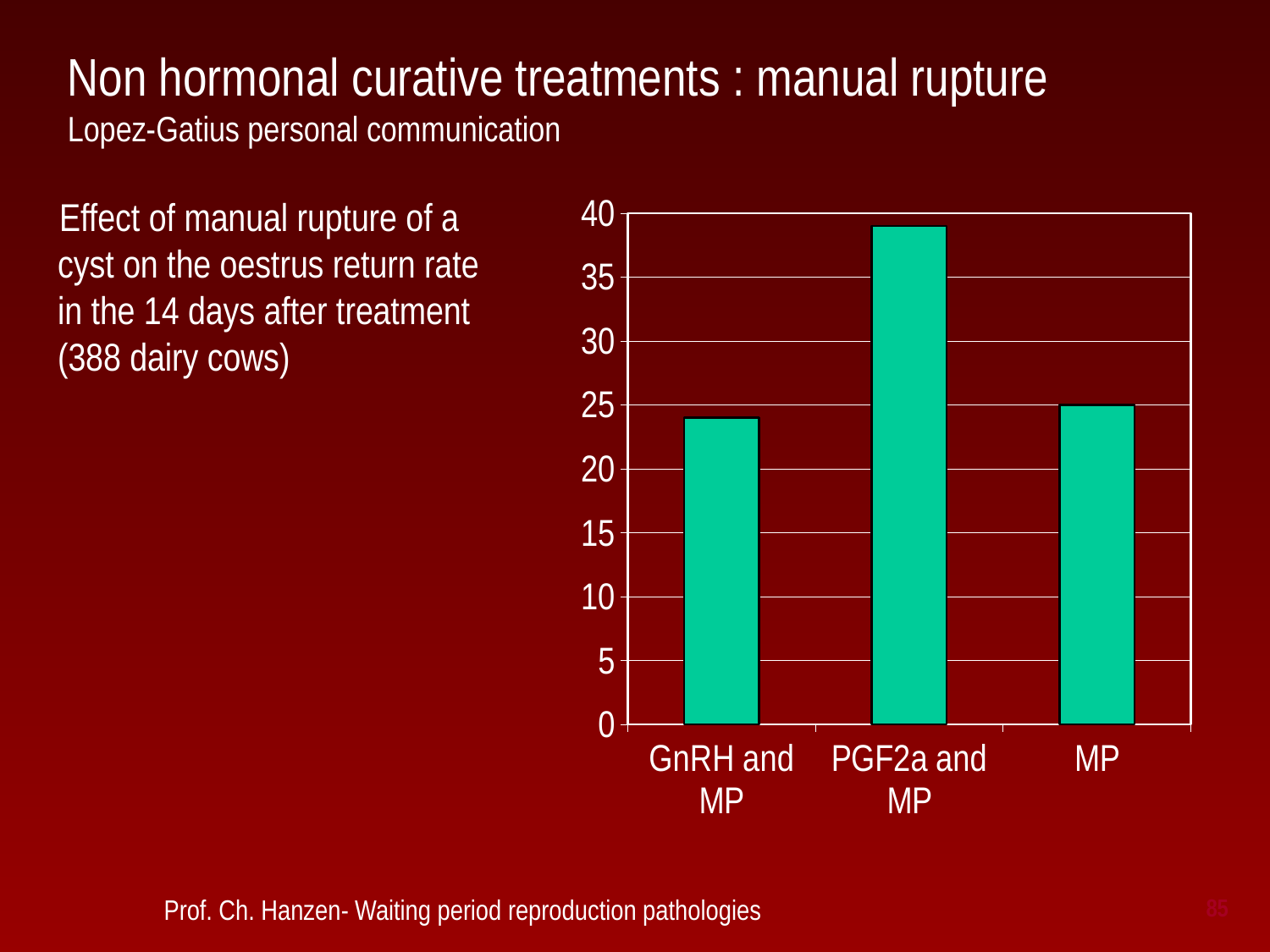
What kind of chart is shown on the slide? bar chart Which is larger in the chart, the value for PGF2a and MP or the value for MP? PGF2a and MP Which is larger in the chart, the value for PGF2a and MP or the value for GnRH and MP? PGF2a and MP Is the value for GnRH and MP greater or less than 20? greater How many treatment categories are shown on the x axis of the chart? 3 Is the value for PGF2a and MP greater or less than 35? greater Is the value for PGF2a and MP greater or less than 40? less What colour are the bars in the chart? green What is the highest value shown on the y axis of the chart? 40 Which treatment has the highest oestrus return rate in the chart? PGF2a and MP